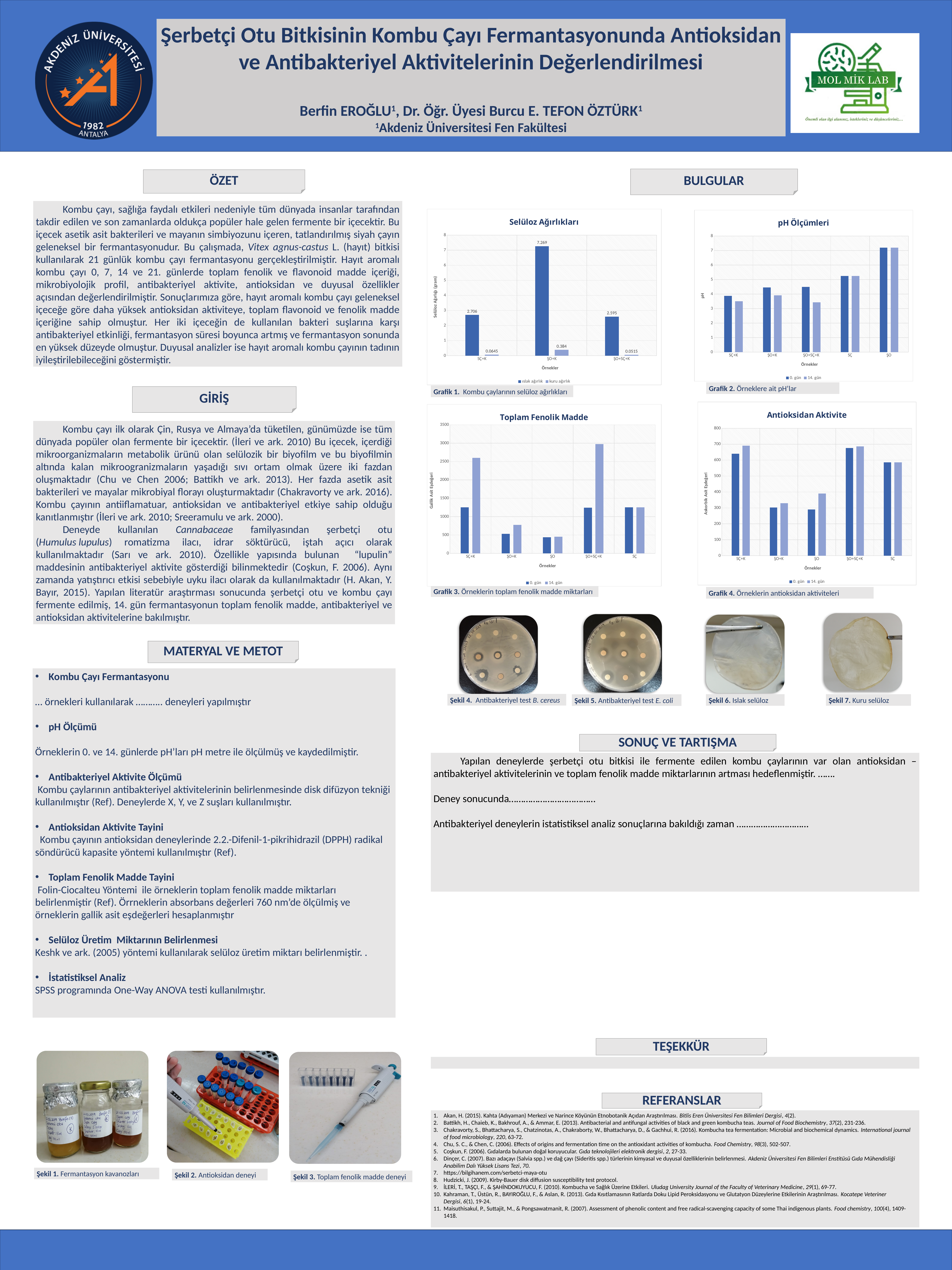
What kind of chart is the 'Antioksidan Aktivite' chart? Bar chart In the 'pH Ölçümleri' chart, which category has the highest pH values? ŞO In the 'Toplam Fenolik Madde' chart, is the 14. gün value for ŞO+SÇ+K greater or less than 2500? greater In the 'Selüloz Ağırlıkları' chart, which category has the highest ıslak ağırlık? ŞO+K In the 'Toplam Fenolik Madde' chart, which category has the lowest values? ŞO In the 'Selüloz Ağırlıkları' chart, what is the kuru ağırlık value for SÇ+K? 0.0645 In the 'Selüloz Ağırlıkları' chart, what is the difference between the ıslak ağırlık values of SÇ+K and ŞO+SÇ+K? 0.111 In the 'Antioksidan Aktivite' chart, which is larger: the 14. gün value for SÇ+K or the 14. gün value for ŞO+K? SÇ+K In the 'Selüloz Ağırlıkları' chart, how many categories are shown on the x axis? 3 In the 'pH Ölçümleri' chart, how many series does the legend list? 2 In the 'Selüloz Ağırlıkları' chart, what is the ıslak ağırlık value for ŞO+K? 7.269 In the 'pH Ölçümleri' chart, is the 0. gün value for ŞO greater or less than 6? greater